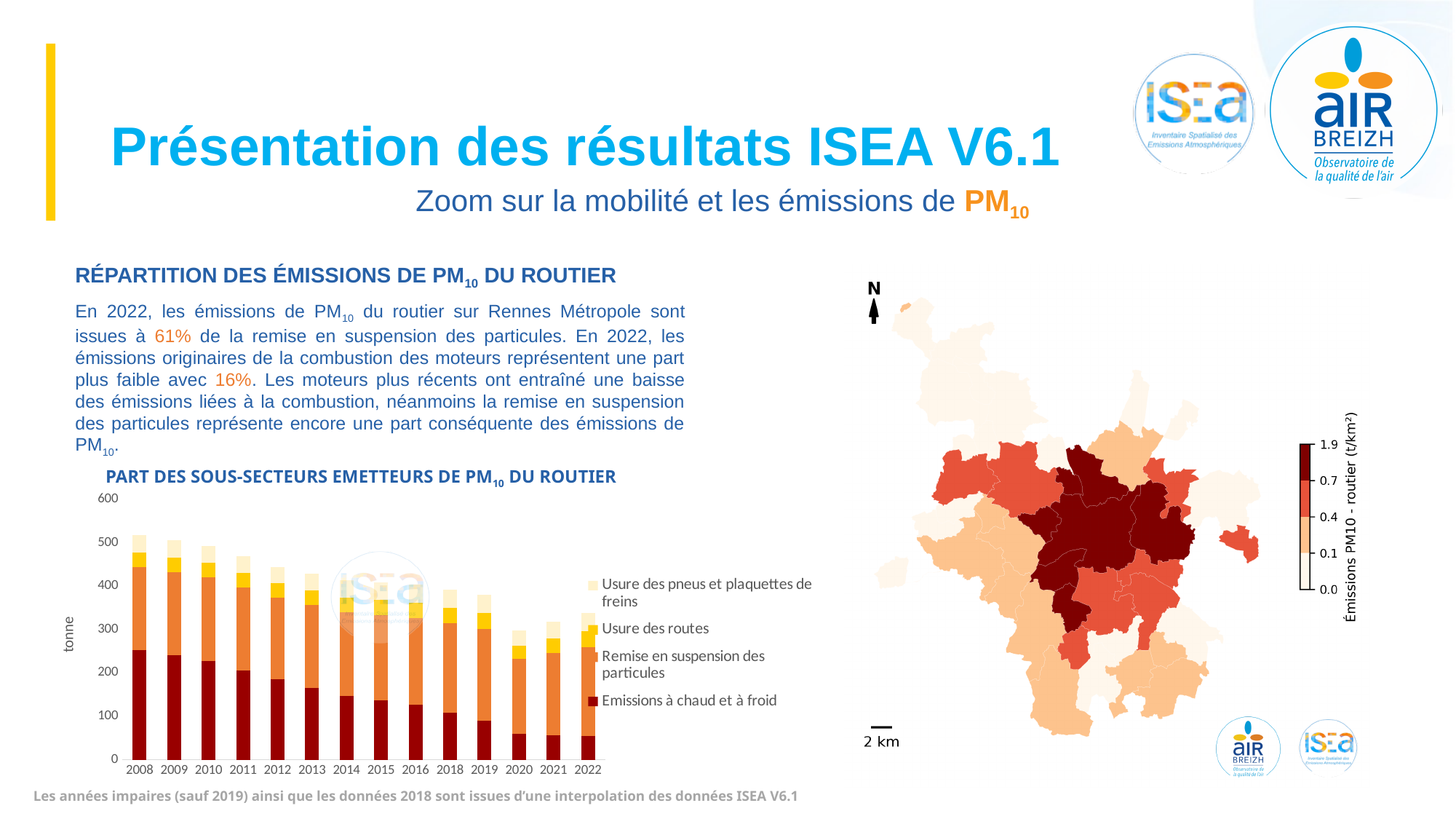
Is the 'Emissions à chaud et à froid' segment for 2008 greater or less than 200? greater Which year has the lowest total bar in the bar chart? 2020 Which year has the highest total bar in the bar chart? 2008 How many years are shown on the x axis of the bar chart? 14 How many series does the legend of the bar chart list? 4 Is the total bar for 2022 in the bar chart greater or less than 400? less What unit is shown on the y axis of the bar chart? tonne Do the total PM10 road emissions in the bar chart rise or fall from 2008 to 2022? Fall Which year has a larger total bar in the bar chart, 2008 or 2022? 2008 What kind of chart is 'PART DES SOUS-SECTEURS EMETTEURS DE PM10 DU ROUTIER'? Stacked bar chart Is the total bar for 2012 in the bar chart greater or less than 500? less